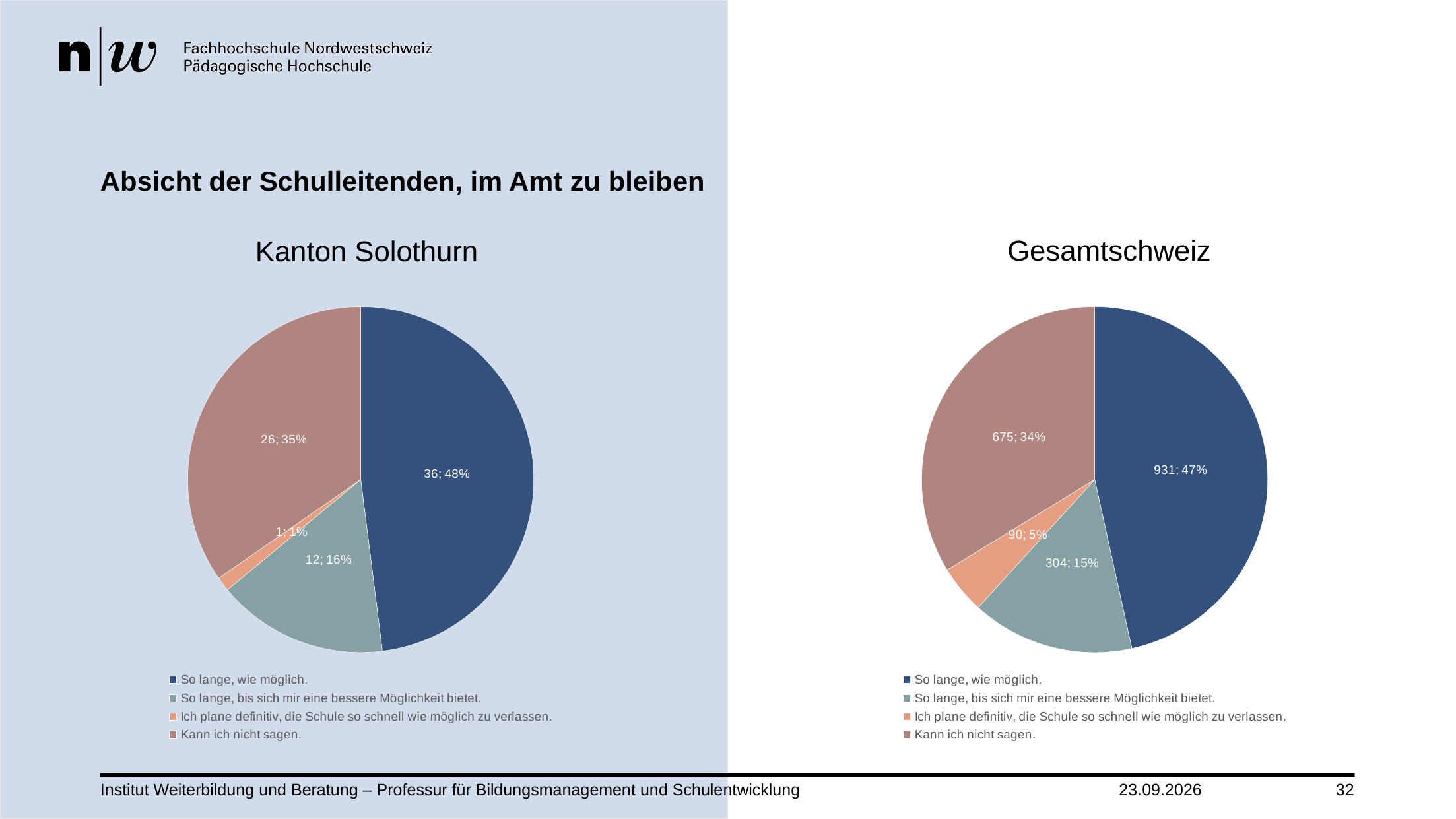
In the Kanton Solothurn chart, what is the data label for the slice 'So lange, wie möglich.'? 36; 48% How many slices does the Gesamtschweiz pie chart have? 4 What type of chart is used for Kanton Solothurn? Pie chart In the Kanton Solothurn chart, which category has the largest slice? So lange, wie möglich. In the Kanton Solothurn chart, which category has the smallest slice? Ich plane definitiv, die Schule so schnell wie möglich zu verlassen. In the Gesamtschweiz chart, what is the data label for 'Ich plane definitiv, die Schule so schnell wie möglich zu verlassen.'? 90; 5% In the Gesamtschweiz chart, what is the difference in count between 'So lange, wie möglich.' and 'Kann ich nicht sagen.'? 256 In the Gesamtschweiz chart, what is the data label for the slice 'Kann ich nicht sagen.'? 675; 34% In the Kanton Solothurn chart, which is larger: 'So lange, bis sich mir eine bessere Möglichkeit bietet.' or 'Kann ich nicht sagen.'? Kann ich nicht sagen. In the Gesamtschweiz chart, which category has the smallest slice? Ich plane definitiv, die Schule so schnell wie möglich zu verlassen. What is the title of the slide above the two charts? Absicht der Schulleitenden, im Amt zu bleiben In the Kanton Solothurn chart, what share of the pie does 'So lange, bis sich mir eine bessere Möglichkeit bietet.' represent? 16%